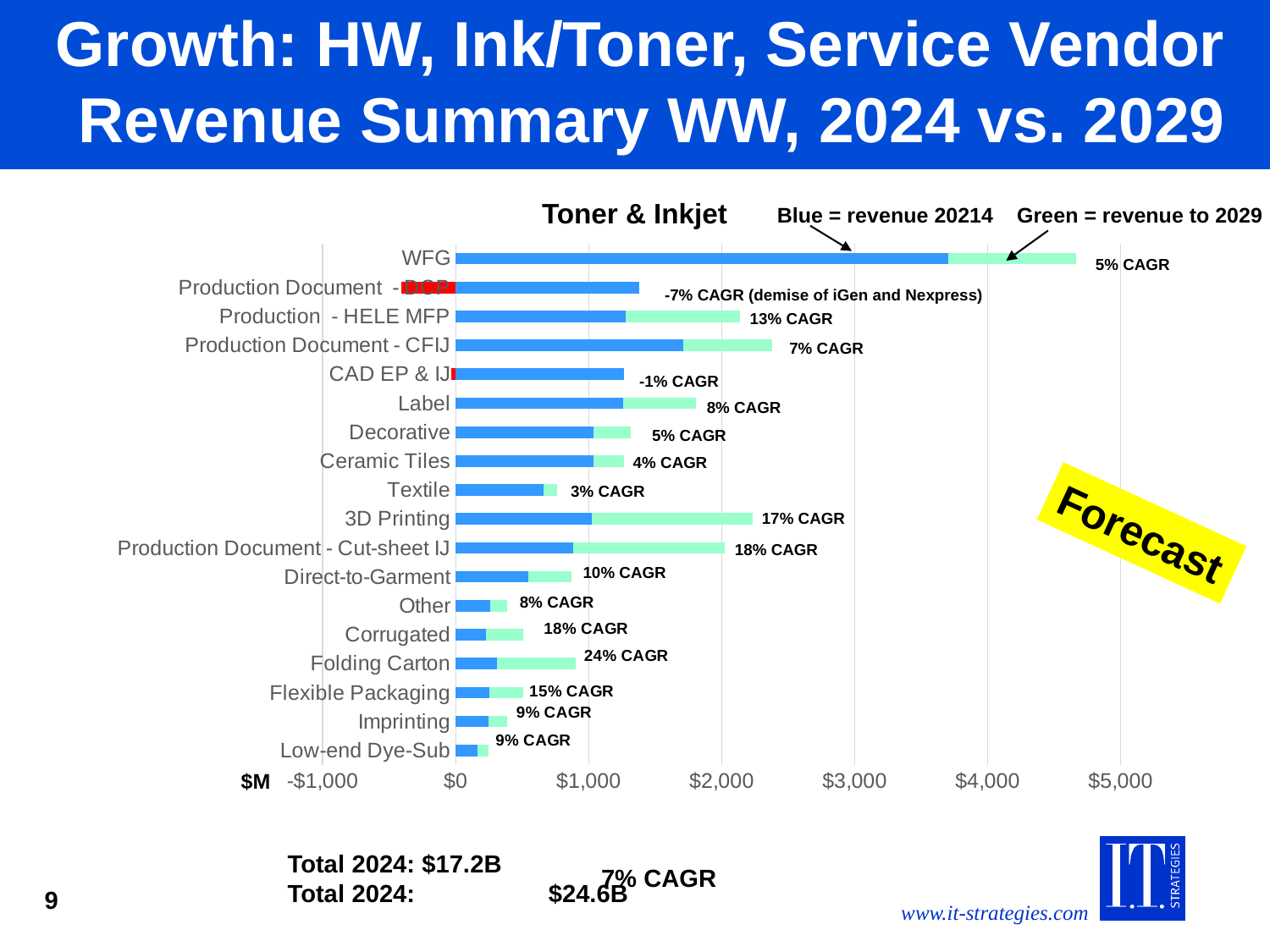
Is the total bar length for WFG greater or less than $4,000? greater What kind of chart is shown on the slide? bar chart What CAGR is shown for Folding Carton? 24% CAGR Is the total bar length for Production Document - CFIJ greater or less than $2,000? greater What CAGR is shown for CAD EP & IJ? -1% CAGR What CAGR is shown for Production Document - Cut-sheet IJ? 18% CAGR How many categories are plotted in the Toner & Inkjet chart? 18 What CAGR is shown for WFG? 5% CAGR Which category has the highest CAGR label? Folding Carton What is the title of the chart? Toner & Inkjet Is the total bar length for Textile greater or less than $1,000? less Which has the higher CAGR, 3D Printing or Textile? 3D Printing